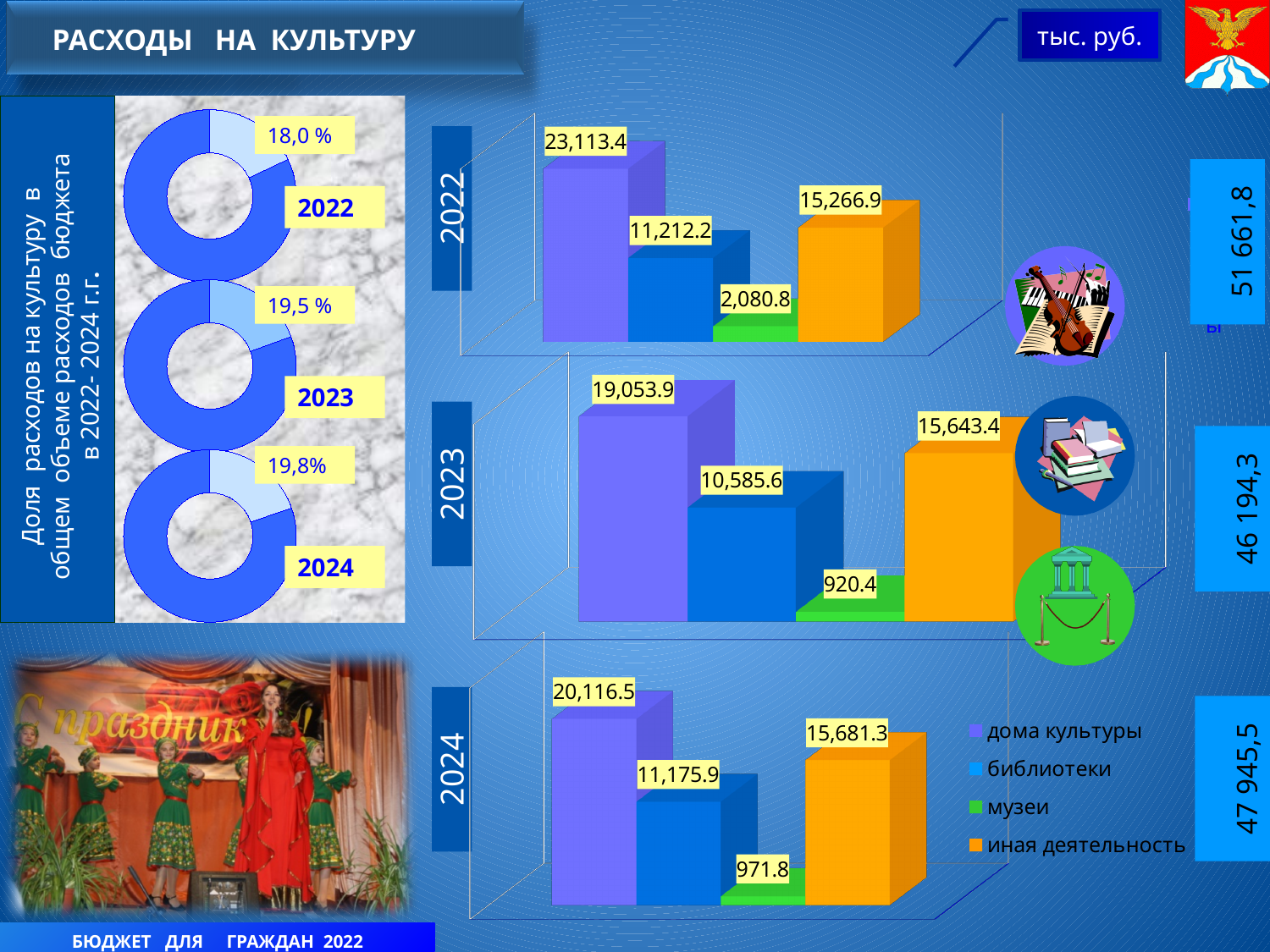
How many categories does each of the yearly bar charts show? 4 How many series does the legend next to the 2024 bar chart list? 4 In the 2024 bar chart, what is the value for библиотеки? 11,175.9 In the 2024 bar chart, what is the difference between дома культуры and библиотеки? 8,940.6 What type of chart is used to show the 2022, 2023 and 2024 expenditure breakdowns? bar chart In the 2022 bar chart, what is the value for дома культуры? 23,113.4 In the 2023 bar chart, what is the value for музеи? 920.4 In the 2023 bar chart, which category has the highest value? дома культуры In the donut chart for 2023 on the left, what share of total budget expenditure goes to culture? 19,5 % In the 2022 bar chart, which category has the lowest value? музеи In the 2022 bar chart, which is larger: библиотеки or иная деятельность? иная деятельность In the 2024 bar chart, what is the value for иная деятельность? 15,681.3